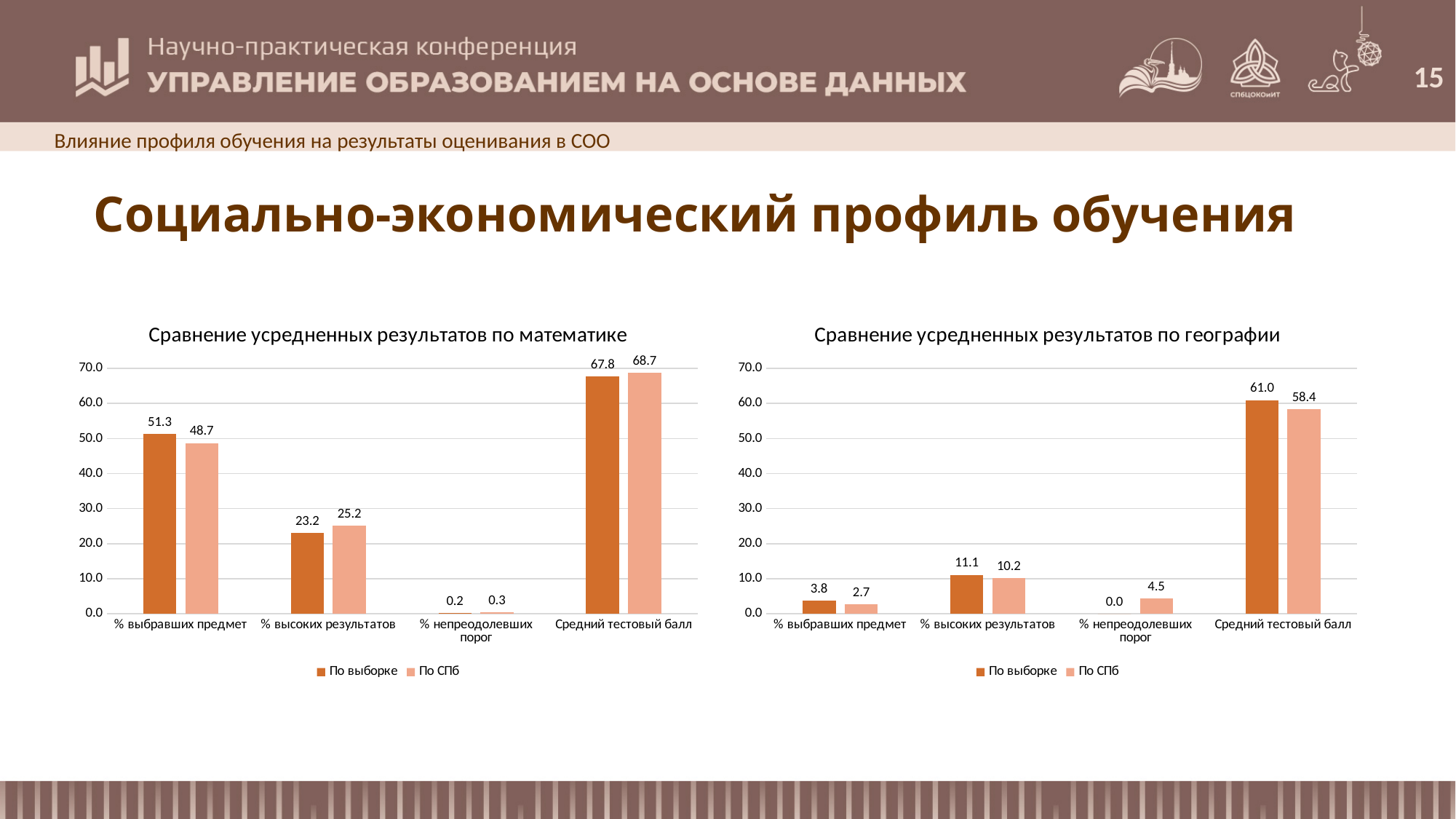
In the chart 'Сравнение усредненных результатов по математике', what is the value of 'По выборке' for '% выбравших предмет'? 51.3 How many categories are shown on the x axis of the chart 'Сравнение усредненных результатов по географии'? 4 In the chart 'Сравнение усредненных результатов по географии', what is the value of 'По СПб' for '% непреодолевших порог'? 4.5 What type of chart is 'Сравнение усредненных результатов по географии'? Bar chart How many series does the legend of the chart 'Сравнение усредненных результатов по математике' list? 2 In the chart 'Сравнение усредненных результатов по географии', which category has the highest value for 'По СПб'? Средний тестовый балл In the chart 'Сравнение усредненных результатов по математике', what is the difference between 'По выборке' and 'По СПб' for '% выбравших предмет'? 2.6 In the chart 'Сравнение усредненных результатов по математике', what is the value of 'По СПб' for 'Средний тестовый балл'? 68.7 In the chart 'Сравнение усредненных результатов по математике', which category has the lowest value for 'По выборке'? % непреодолевших порог In the chart 'Сравнение усредненных результатов по географии', what is the value of 'По выборке' for '% высоких результатов'? 11.1 In the chart 'Сравнение усредненных результатов по географии', what is the difference between 'По выборке' and 'По СПб' for 'Средний тестовый балл'? 2.6 In the chart 'Сравнение усредненных результатов по математике', which is larger for '% высоких результатов': 'По выборке' or 'По СПб'? По СПб